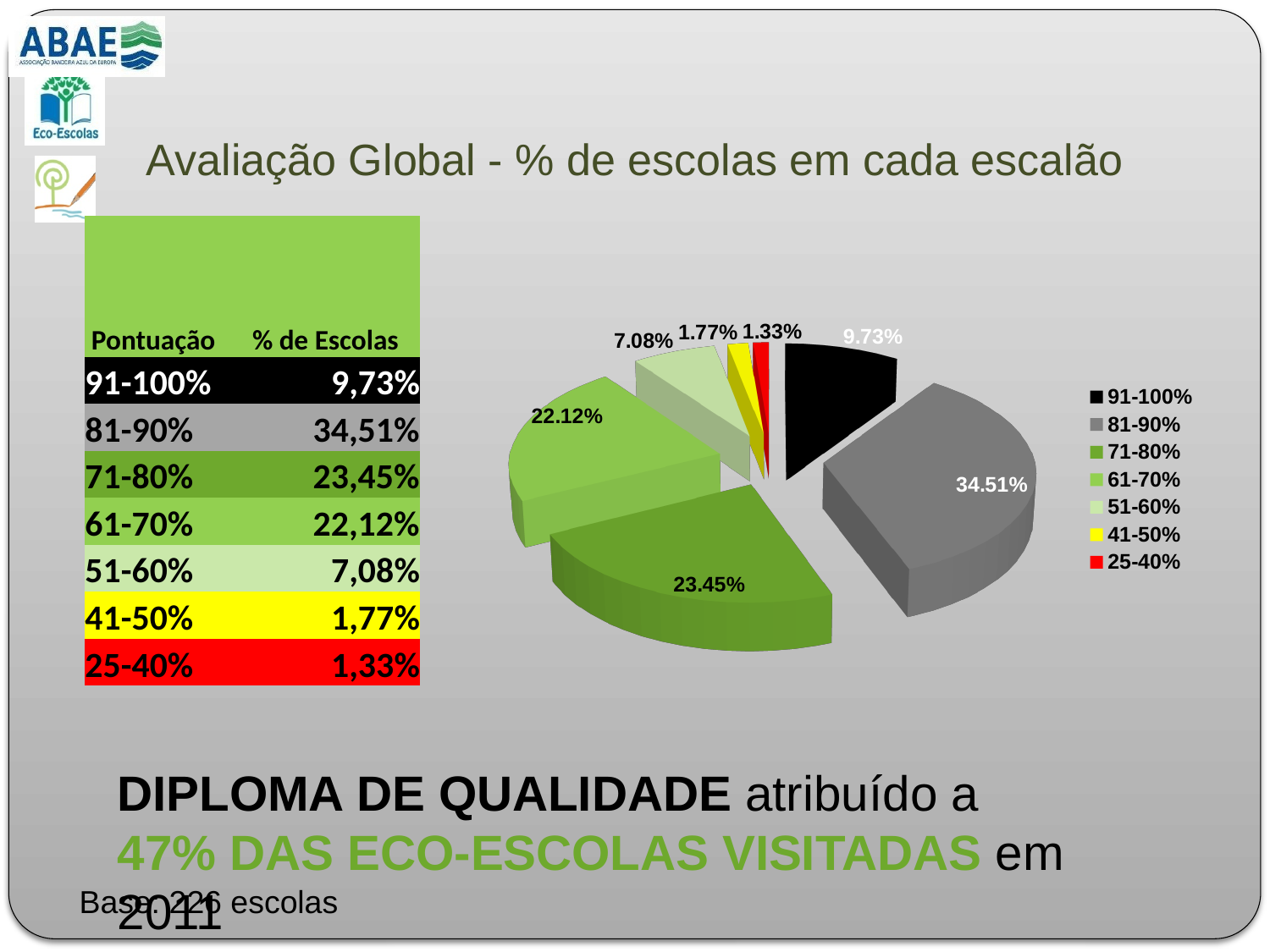
Which score band has the largest slice in the pie chart? 81-90% What percentage does the pie chart show for the 71-80% score band? 23.45% How many slices does the pie chart have? 7 What kind of chart is shown on the slide? pie chart What colour is the 41-50% slice in the pie chart? yellow What percentage does the pie chart show for the 81-90% score band? 34.51% What percentage does the pie chart show for the 61-70% score band? 22.12% How many entries does the pie chart's legend list? 7 Which score band has the smallest slice in the pie chart? 25-40% What percentage does the pie chart show for the 25-40% score band? 1.33% What is the difference in percentage points between the 81-90% slice and the 71-80% slice in the pie chart? 11.06 In the pie chart, which slice is larger: 91-100% or 51-60%? 91-100%